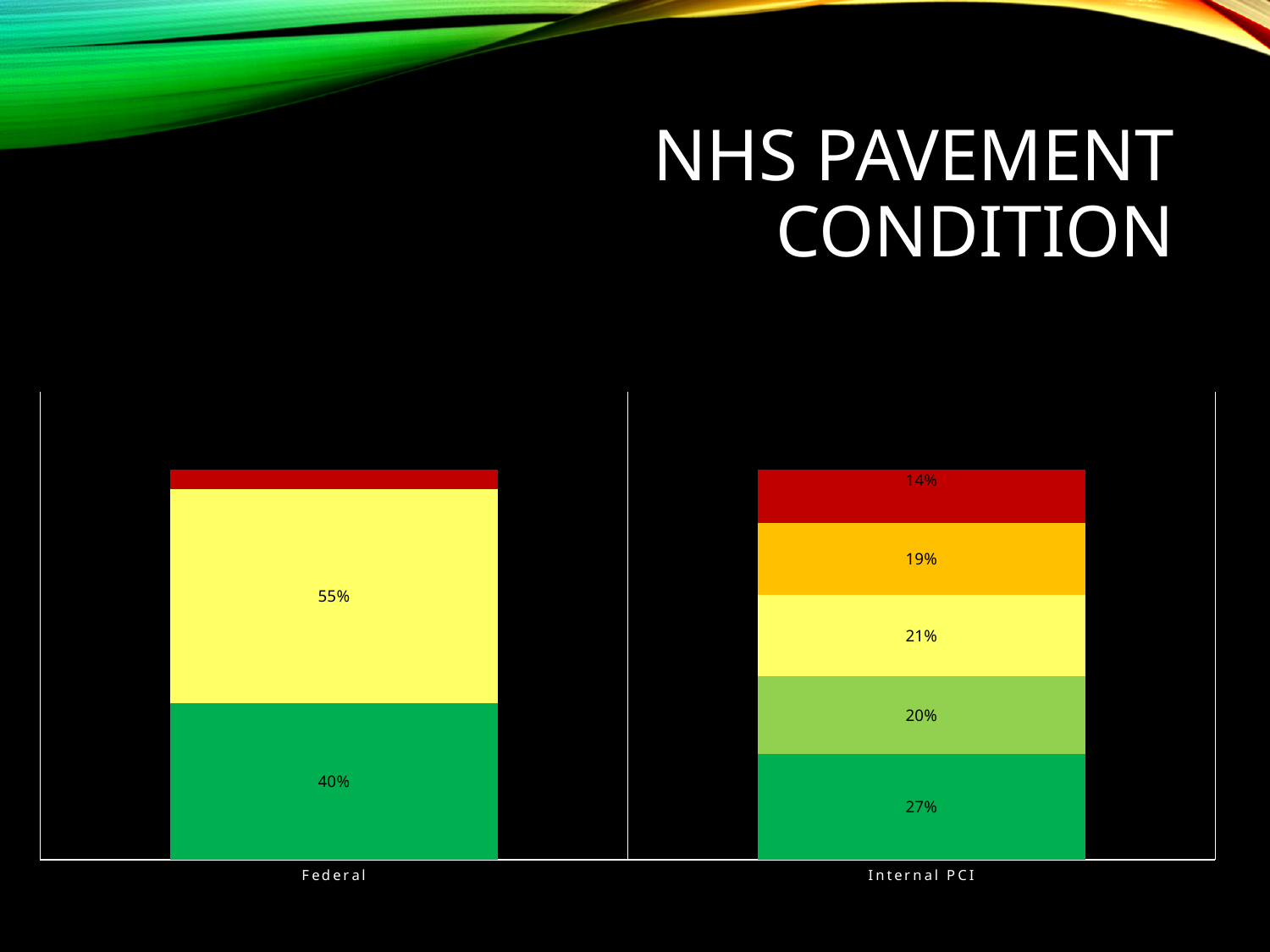
In the Internal PCI chart on the right, what value is labelled on the yellow segment? 21% In the Internal PCI chart on the right, what value is labelled on the light green segment? 20% Which is larger: the green bottom segment in the Federal chart or the green bottom segment in the Internal PCI chart? Federal In the Internal PCI chart on the right, which segment has the largest value? The green bottom segment (27%) In the Internal PCI chart on the right, what value is labelled on the red top segment? 14% In the Internal PCI chart on the right, what value is labelled on the orange segment? 19% How many segments make up the stacked bar in the Internal PCI chart on the right? 5 In the Internal PCI chart on the right, what value is labelled on the green bottom segment? 27% In the Federal chart on the left, what value is labelled on the yellow segment? 55% In the Federal chart on the left, what value is labelled on the green bottom segment? 40% In the Federal chart on the left, what is the difference between the yellow segment and the green segment? 15% In the Internal PCI chart on the right, which segment has the smallest value? The red top segment (14%)